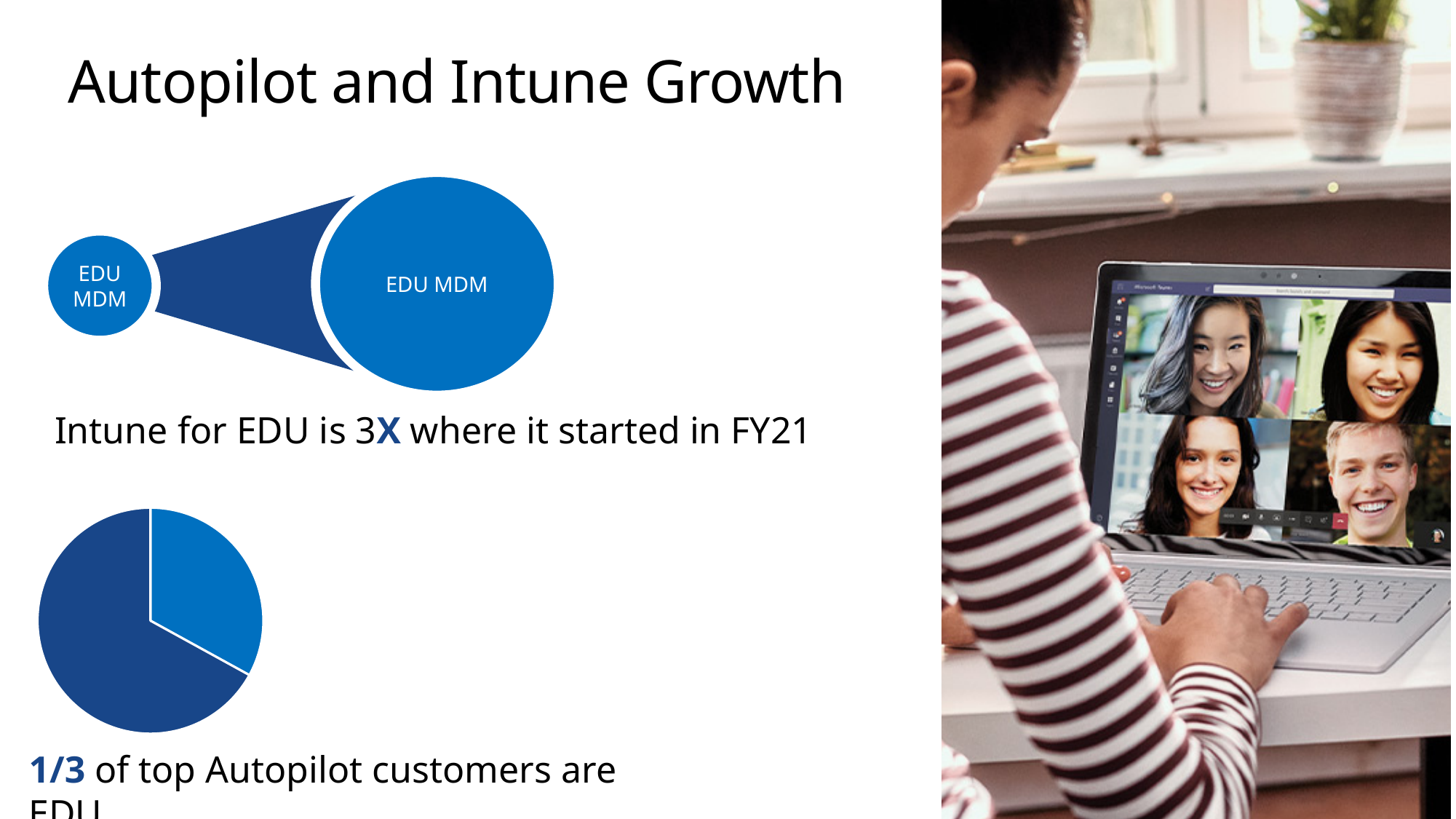
What kind of chart is shown at the bottom left of the slide? pie chart In the pie chart at the bottom left, is the lighter blue slice greater or less than half of the pie? less According to the slide, Intune for EDU is how many times where it started in FY21? 3X In the growth diagram at the top left, which circle is larger, the left one or the right one? the right one In the pie chart at the bottom left, is the dark blue slice or the lighter blue slice larger? dark blue In the growth diagram at the top left, what label appears in both circles? EDU MDM How many slices does the pie chart at the bottom left have? 2 According to the slide, what share of top Autopilot customers are EDU? 1/3 What is the title of the slide? Autopilot and Intune Growth